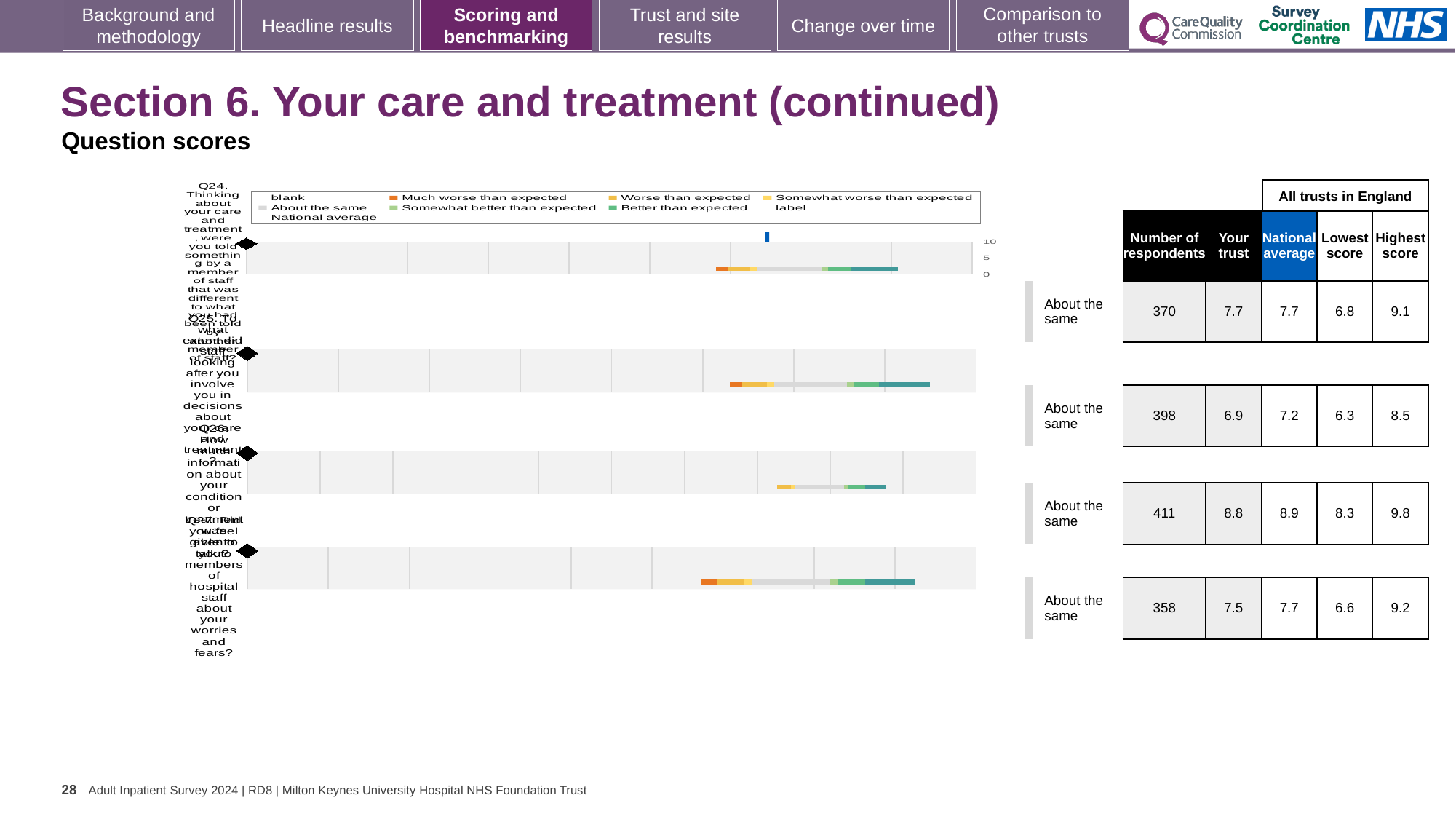
What is the highest score among all trusts in England for the fourth question (Q27)? 9.2 What benchmark category is shown for each of the four questions on this slide? About the same What kind of chart is used to show the benchmarking results for each question on this slide? bar chart What is the difference between the national average and the trust score for Q25? 0.3 What is the lowest score among all trusts in England for Q24? 6.8 Is the trust score for Q26 higher or lower than the trust score for Q24? higher Which of the four questions has the highest number of respondents? Q26 What is the national average for the third question (Q26)? 8.9 How many question charts (Q24 to Q27) are shown on the slide? 4 Which of the four questions has the lowest 'Your trust' score? Q25 What is the 'Your trust' score for the second question (Q25)? 6.9 What is the number of respondents for the first question (Q24)? 370